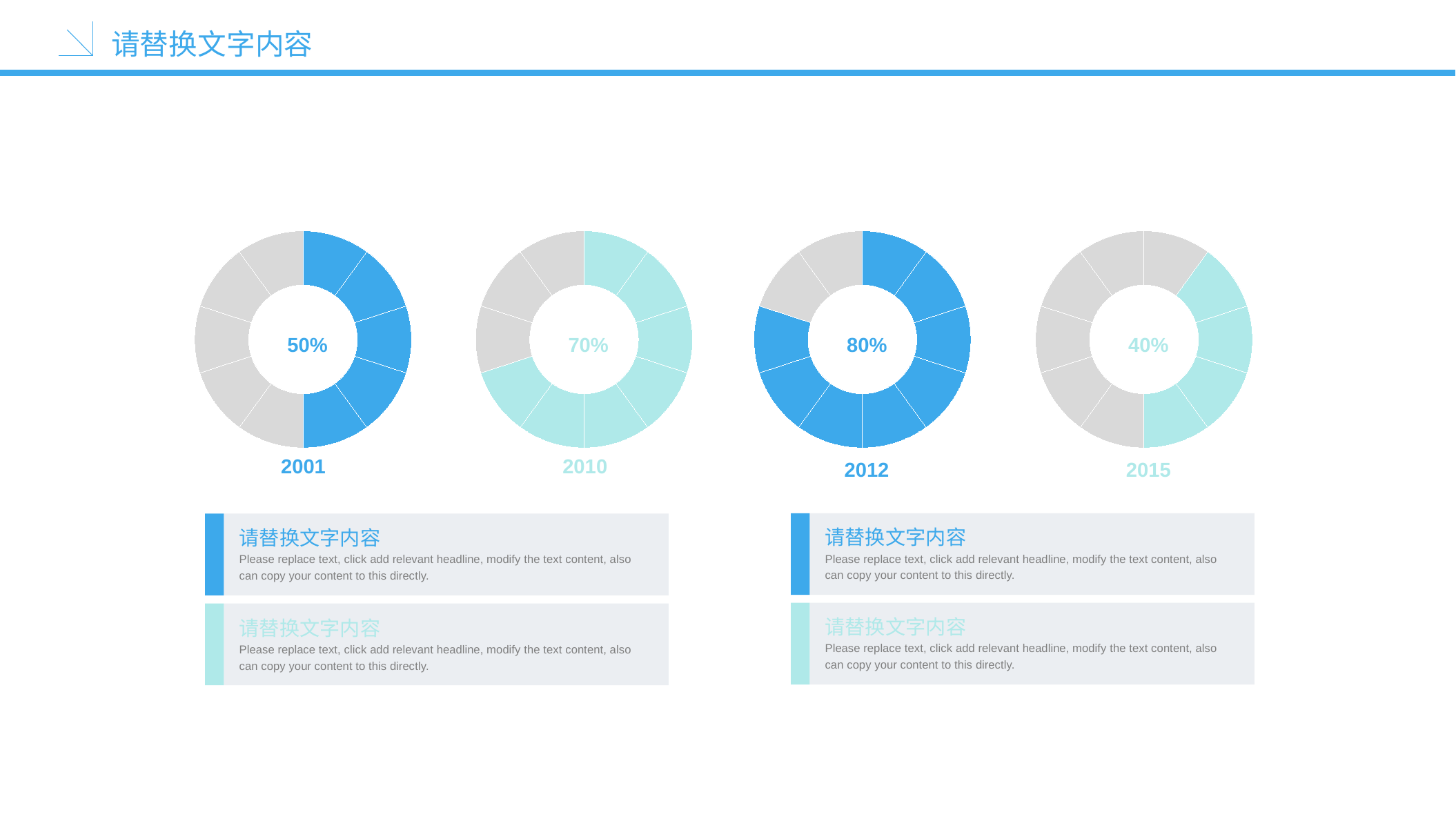
Which year's donut chart shows the highest percentage? 2012 What percentage is shown in the centre of the donut chart labelled 2012? 80% What is the difference between the percentage shown for 2012 and the percentage shown for 2015? 40% What percentage is shown in the centre of the donut chart labelled 2001? 50% What percentage is shown in the centre of the donut chart labelled 2015? 40% Which shows a larger percentage, the 2010 donut chart or the 2001 donut chart? 2010 Which year's donut chart shows the lowest percentage? 2015 What is the difference between the percentage shown for 2010 and the percentage shown for 2001? 20% What colour is the filled portion of the donut chart labelled 2001? Blue What kind of chart is used to show the percentage for each year? Donut chart What percentage is shown in the centre of the donut chart labelled 2010? 70% How many donut charts are on the slide? 4